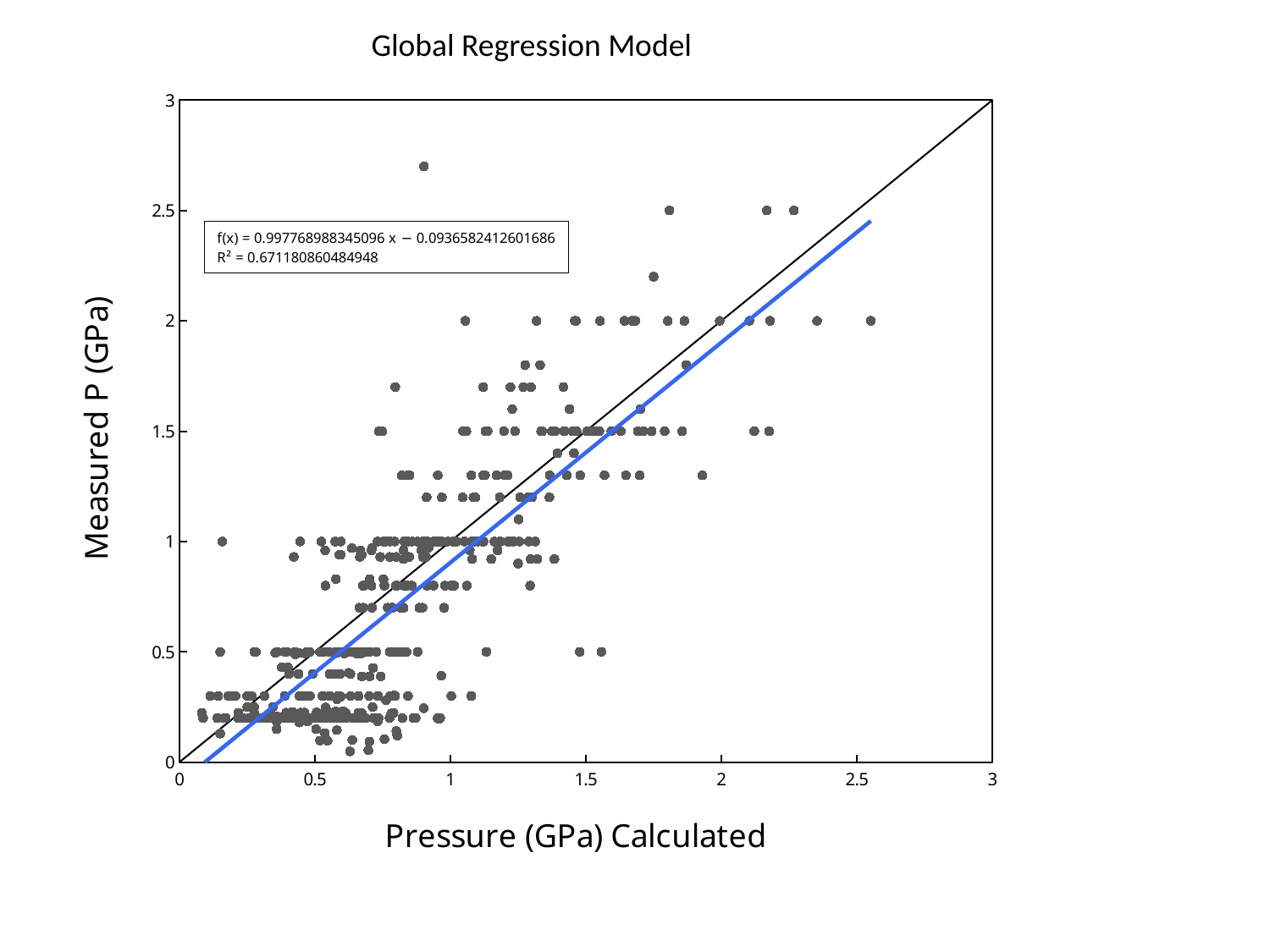
Is the highest measured P value plotted greater or less than 3 GPa? less What is the maximum value shown on the y axis? 3 What R² value is printed in the text box on the chart? 0.671180860484948 What is the slope of the fitted line f(x) shown in the text box? 0.997768988345096 What kind of chart is shown on the slide? Scatter chart What is the intercept of the fitted line f(x) shown in the text box? −0.0936582412601686 What is the title of the chart? Global Regression Model What is the label of the x axis? Pressure (GPa) Calculated Is the highest measured P value plotted greater or less than 2.5 GPa? greater Is the R² value of the regression greater or less than 0.5? greater Do the measured P values generally rise or fall as the calculated pressure increases along the x axis? Rise